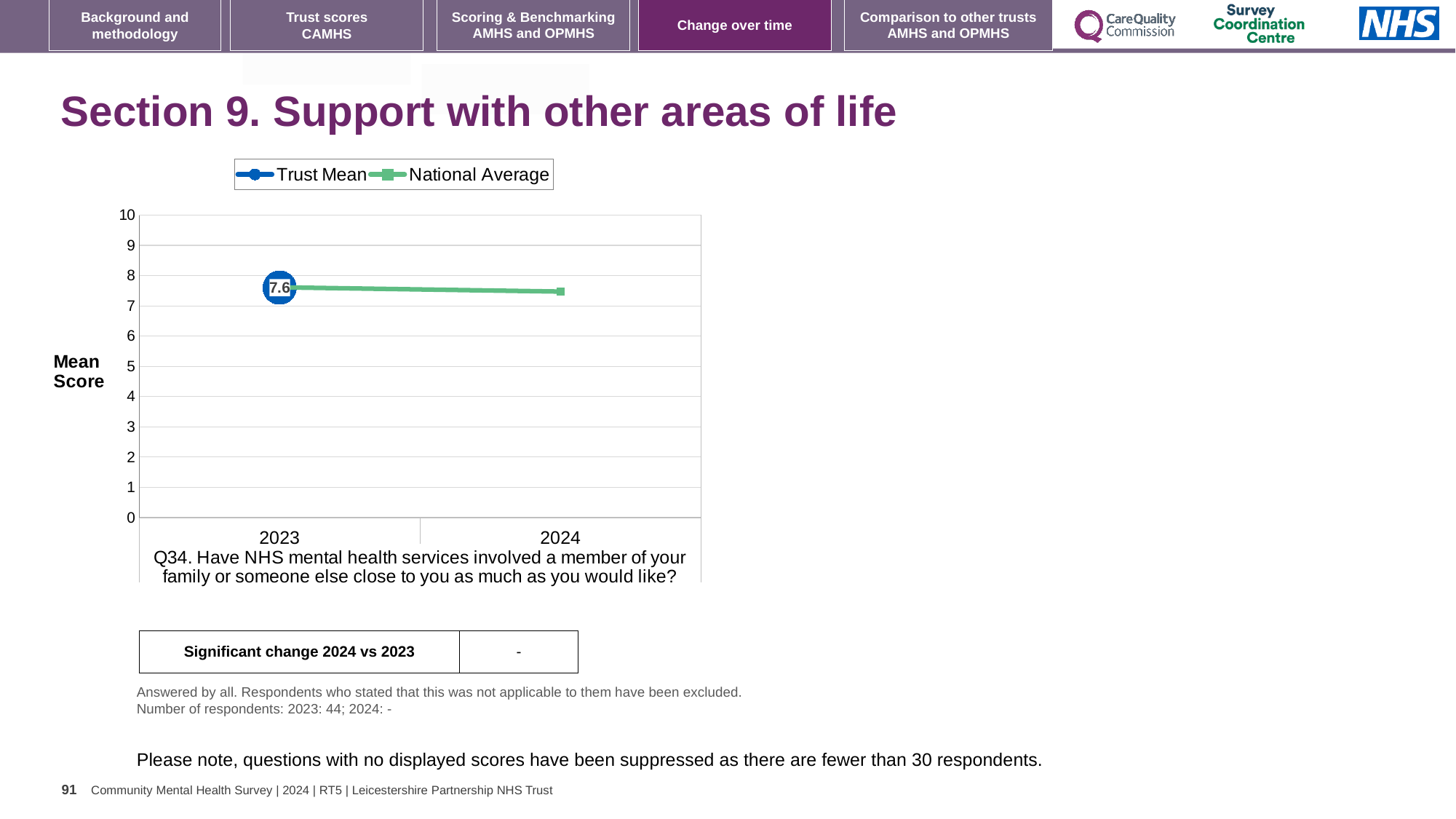
Is the Trust Mean value for 2023 greater or less than 7? greater What are the two series named in the legend? Trust Mean and National Average Is the National Average value for 2024 greater or less than 5? greater How many series does the legend list? 2 How many years are shown on the x axis? 2 What kind of chart is shown on the slide? Line chart What is the Trust Mean score for 2023? 7.6 Does the National Average rise or fall from 2023 to 2024? Falls Is the National Average value for 2024 greater or less than 8? less What is the label on the y axis of the chart? Mean Score